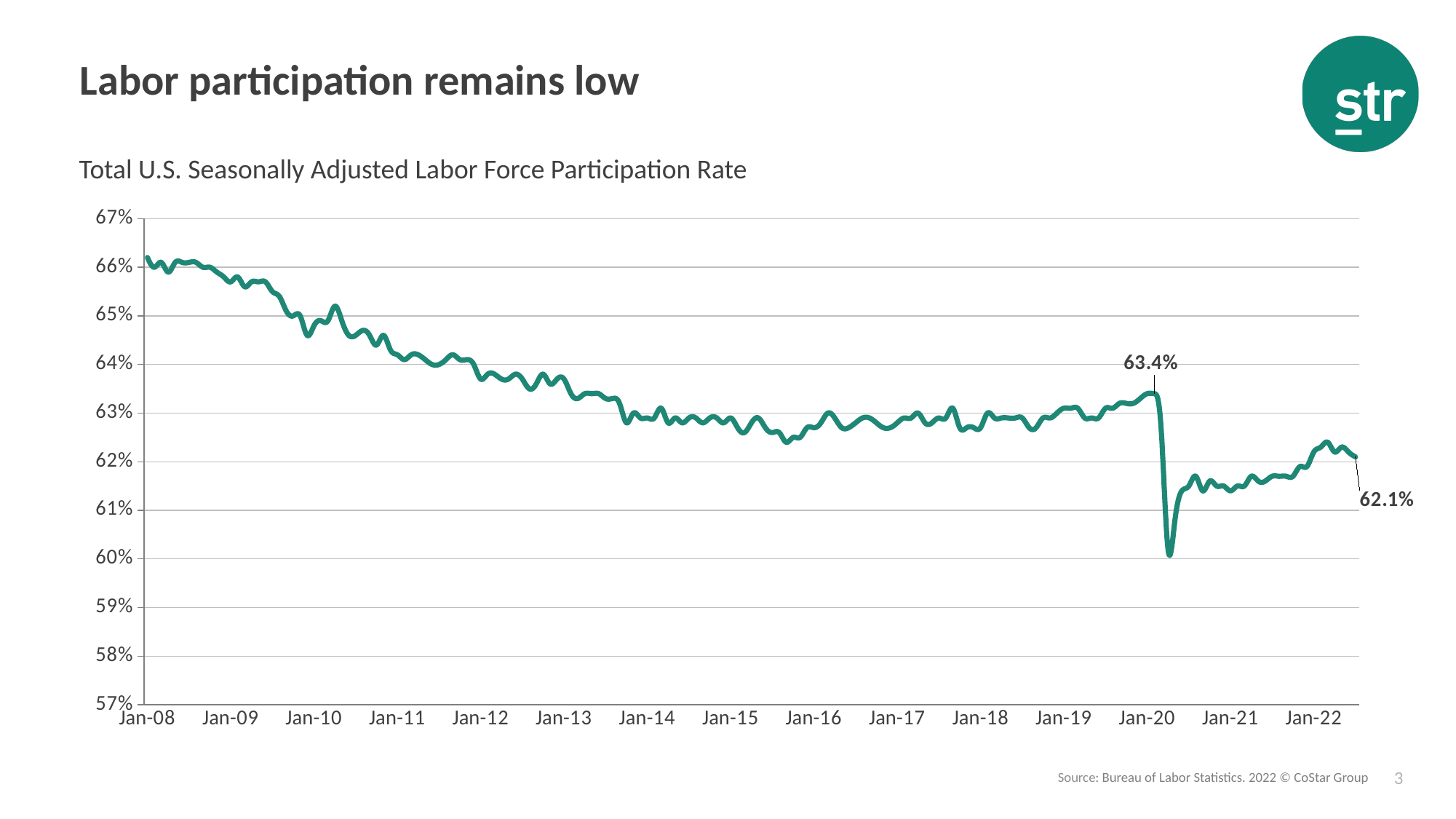
What is the labeled peak value of the labor force participation rate just before the 2020 drop? 63.4% What is the difference between the labeled 63.4% peak and the final labeled value of 62.1%? 1.3 percentage points Is the value at Jan-21 greater or less than 62%? less Does the participation rate rise or fall between Jan-08 and Jan-14? fall In which year does the line reach its lowest point? 2020 What is the source cited for the chart data? Bureau of Labor Statistics What is the labeled value at the end of the series in 2022? 62.1% Is the labor force participation rate at Jan-08 greater or less than 65%? greater Is the lowest point of the line in 2020 greater or less than 61%? less Which is larger, the participation rate at Jan-08 or at Jan-22? Jan-08 What is the title of the chart? Total U.S. Seasonally Adjusted Labor Force Participation Rate What kind of chart is shown on the slide? line chart